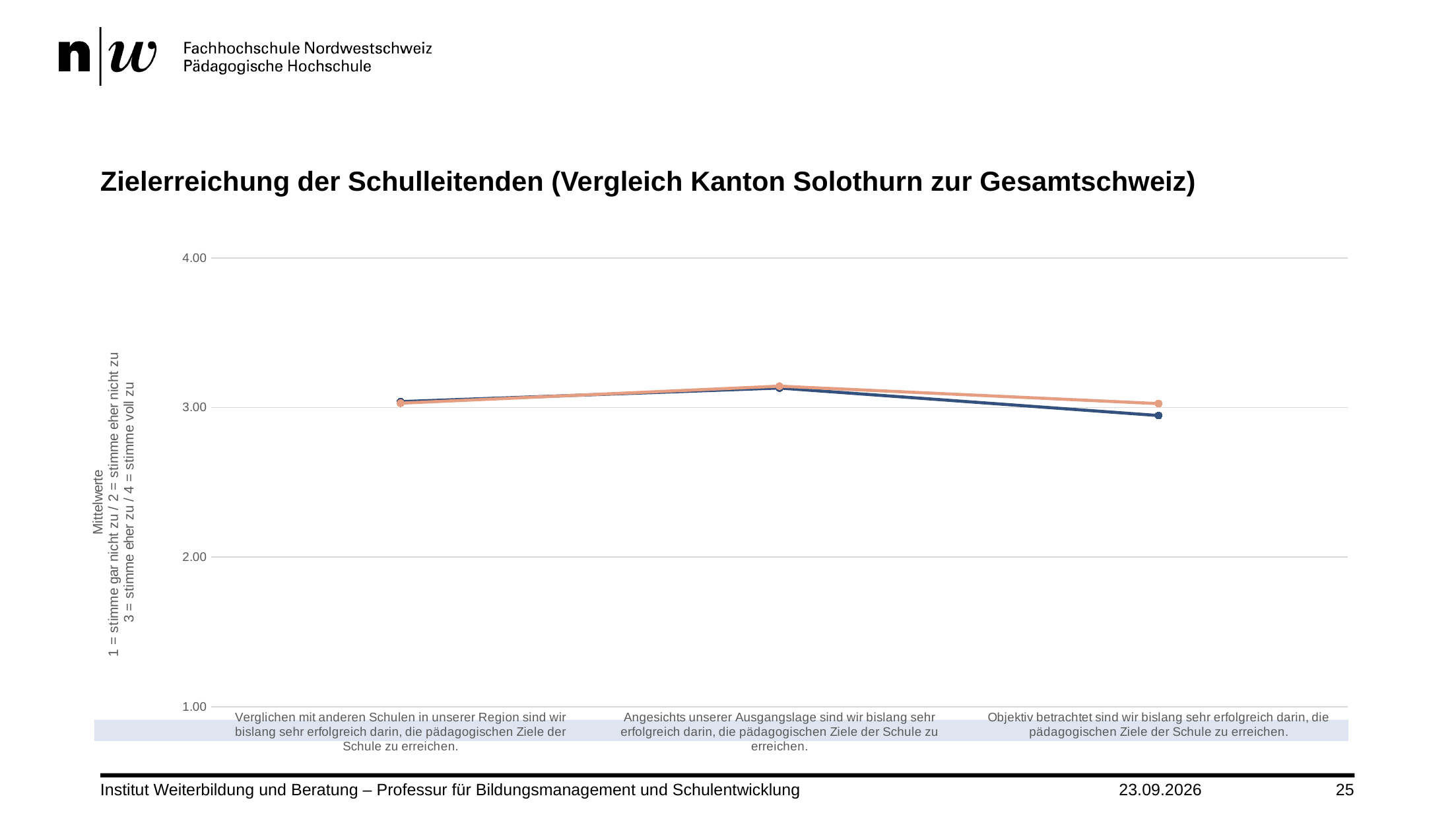
For the third category ("Objektiv betrachtet ..."), which line has the higher value, the orange line or the dark blue line? the orange line For the dark blue line, which category has the lowest value? Objektiv betrachtet sind wir bislang sehr erfolgreich darin, die pädagogischen Ziele der Schule zu erreichen. What is the title of the chart? Zielerreichung der Schulleitenden (Vergleich Kanton Solothurn zur Gesamtschweiz) For the orange line, which category has the highest value? Angesichts unserer Ausgangslage sind wir bislang sehr erfolgreich darin, die pädagogischen Ziele der Schule zu erreichen. What kind of chart is shown on the slide? line chart How many categories are shown on the x axis of the chart? 3 Is the dark blue line's value for the third category ("Objektiv betrachtet ...") greater or less than 3.00? less Is the dark blue line's value for the second category ("Angesichts unserer Ausgangslage ...") greater or less than 3.00? greater What is the highest value shown on the y axis of the chart? 4.00 Does the dark blue line rise or fall between the second and the third category? fall For the dark blue line, which category has the highest value? Angesichts unserer Ausgangslage sind wir bislang sehr erfolgreich darin, die pädagogischen Ziele der Schule zu erreichen. How many lines are plotted in the chart? 2